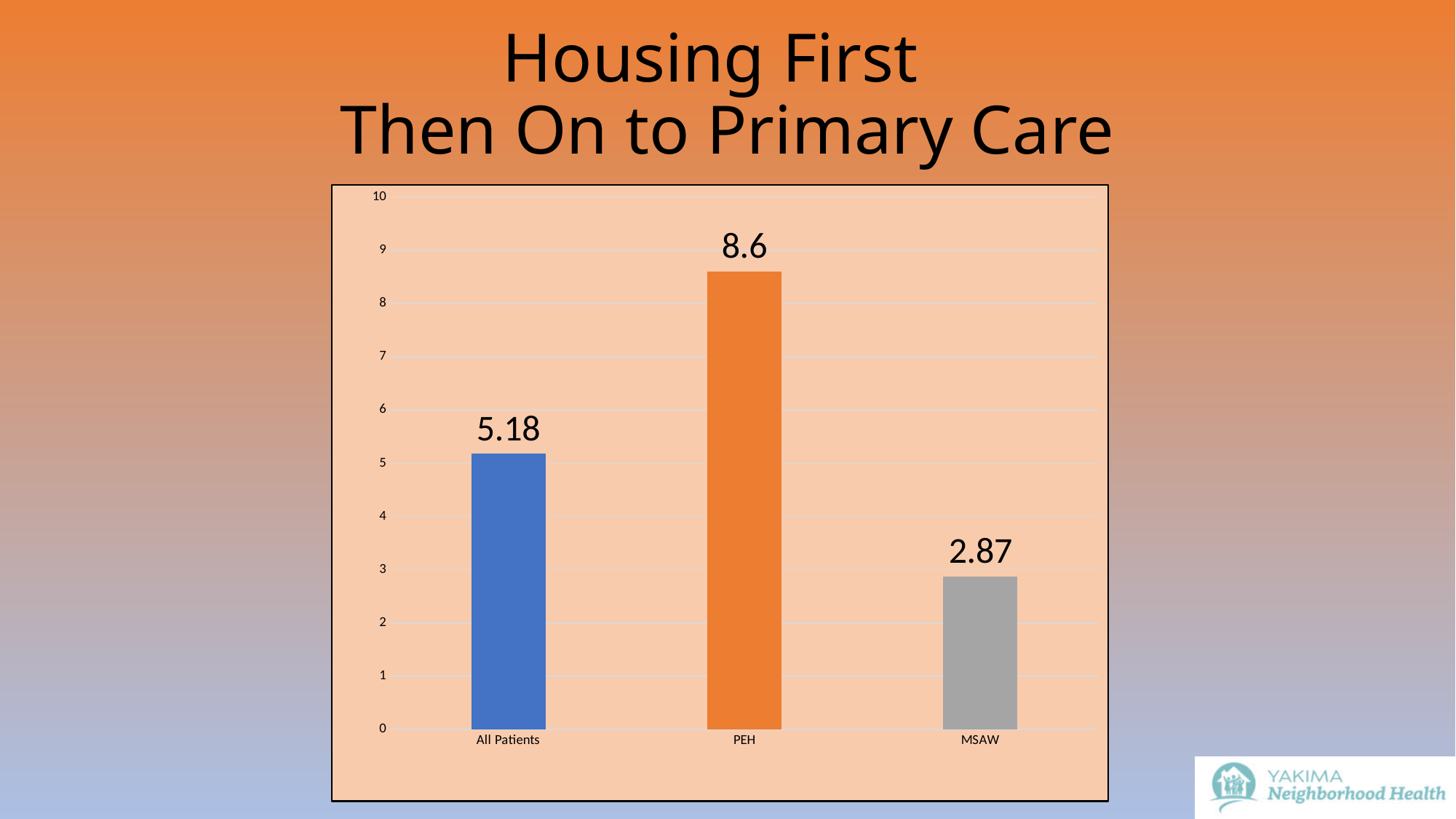
Which category has the highest value? PEH Which is larger, the value for PEH or the value for MSAW? PEH What is the value for PEH? 8.6 What is the value for All Patients? 5.18 Is the value for PEH greater or less than 8? greater What is the difference between the values for All Patients and MSAW? 2.31 What is the title of the slide? Housing First Then On to Primary Care What kind of chart is shown on the slide? bar chart How many categories are shown on the x axis? 3 Which category has the lowest value? MSAW What is the value for MSAW? 2.87 What is the difference between the values for PEH and All Patients? 3.42